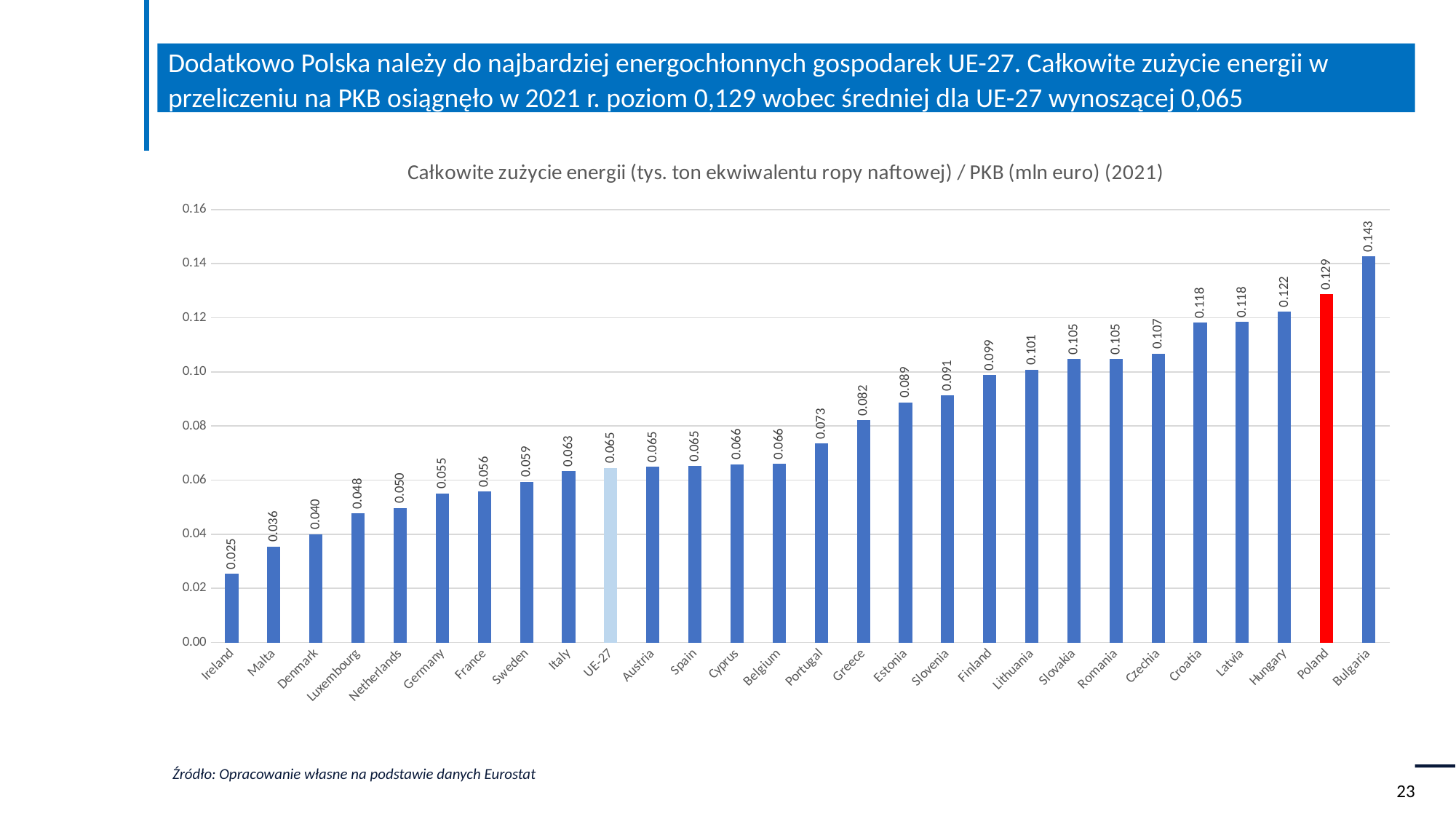
Which country has the highest value? Bulgaria What is the value for Poland? 0.129 What is the value for UE-27? 0.065 Which has a larger value, Hungary or Greece? Hungary What kind of chart is shown on the slide? bar chart How many bars are shown in the chart? 28 Is the value for Bulgaria greater or less than 0.14? greater What is the difference between the values for Poland and UE-27? 0.064 Which bar is coloured red? Poland What is the value for Germany? 0.055 Which country has the lowest value? Ireland Do the values rise or fall from left to right along the x axis? rise